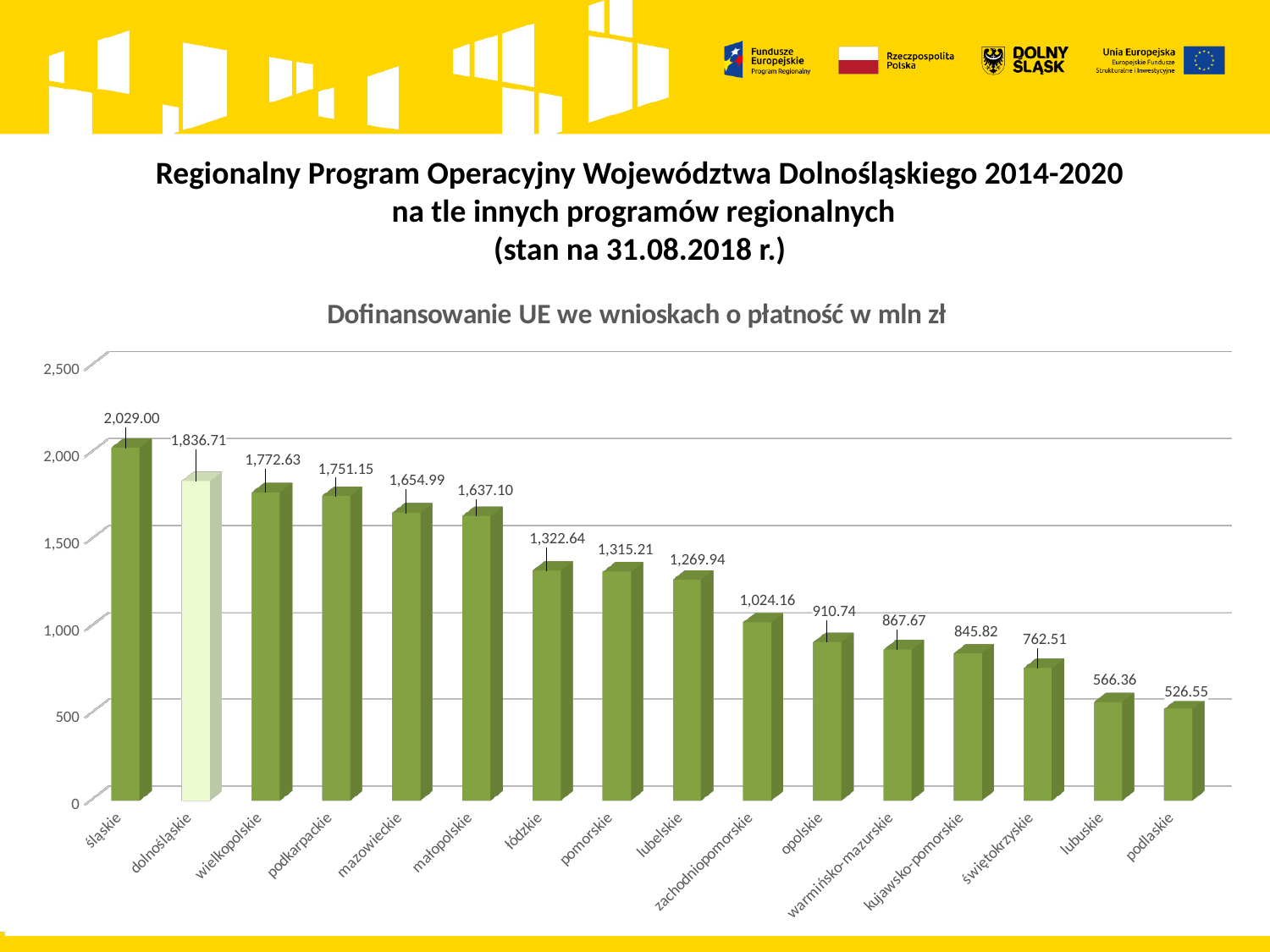
What is the value for świętokrzyskie? 762.51 How many regions are shown on the chart? 16 Which bar is shown in a lighter colour than the others? dolnośląskie Which is larger, the value for opolskie or the value for kujawsko-pomorskie? opolskie What is the value for zachodniopomorskie? 1,024.16 Which region has the lowest value? podlaskie What is the value for dolnośląskie? 1,836.71 Which region has the highest value? śląskie Do the values rise or fall from left to right along the x axis? fall What is the difference between the values for śląskie and dolnośląskie? 192.29 What kind of chart is shown on the slide? bar chart What is the difference between the values for lubuskie and podlaskie? 39.81